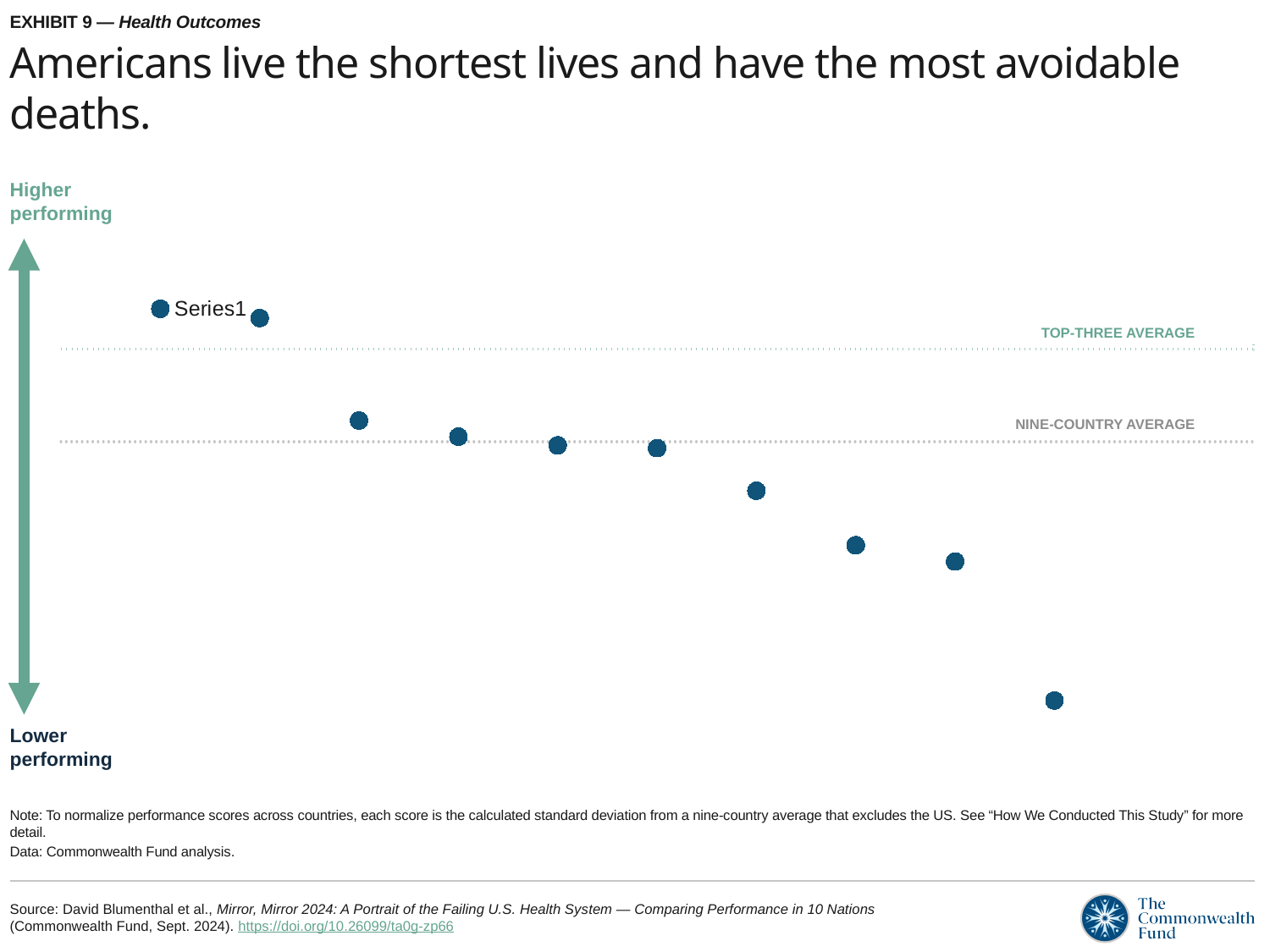
Which data point is the highest on the chart, the leftmost or the rightmost? the leftmost What are the two reference lines on the chart labelled? TOP-THREE AVERAGE and NINE-COUNTRY AVERAGE How many data points are plotted on the chart? 10 What kind of chart is shown on the slide? scatter chart Is the rightmost data point above or below the NINE-COUNTRY AVERAGE line? below Which data point is the lowest on the chart, the leftmost or the rightmost? the rightmost Do the plotted values rise or fall from left to right along the x axis? fall Is the leftmost data point above or below the TOP-THREE AVERAGE line? above